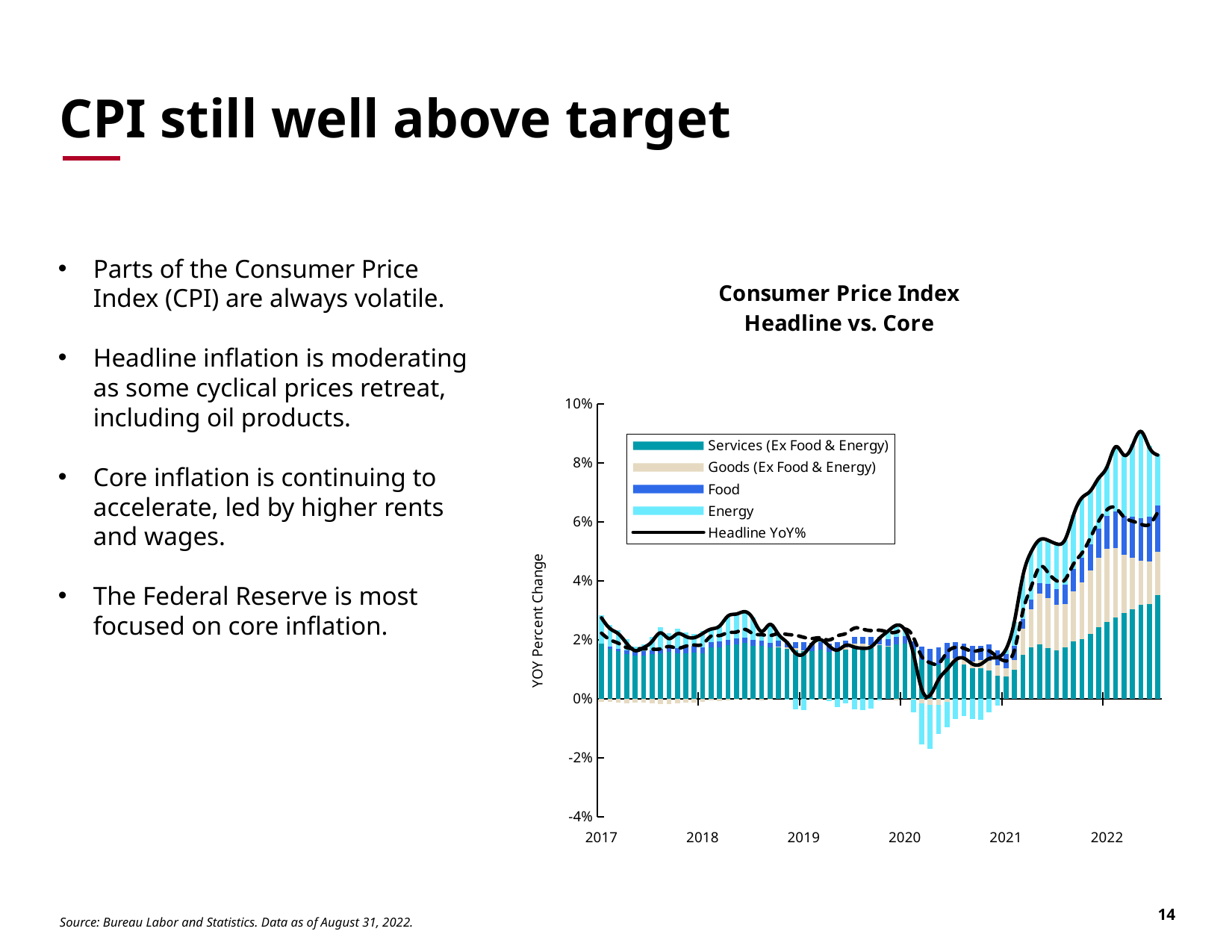
Which is larger, the Headline YoY% value at the start of 2022 or at the start of 2019? Start of 2022 Is the Services (Ex Food & Energy) contribution at the end of the chart greater or less than 2%? greater What is the label on the vertical axis of the chart? YOY Percent Change In which year shown on the x axis does the Headline YoY% line reach its lowest level? 2020 How many series does the chart's legend list? 5 Is the Energy contribution in mid-2020 greater or less than 0%? less Is the Headline YoY% value at the start of 2017 greater or less than 4%? less In which year shown on the x axis does the Headline YoY% line reach its highest level? 2022 What is the title of the chart? Consumer Price Index Headline vs. Core Does the Headline YoY% line rise or fall between the start of 2021 and the start of 2022? rise What kind of chart is shown on the slide? Stacked bar chart with line overlay